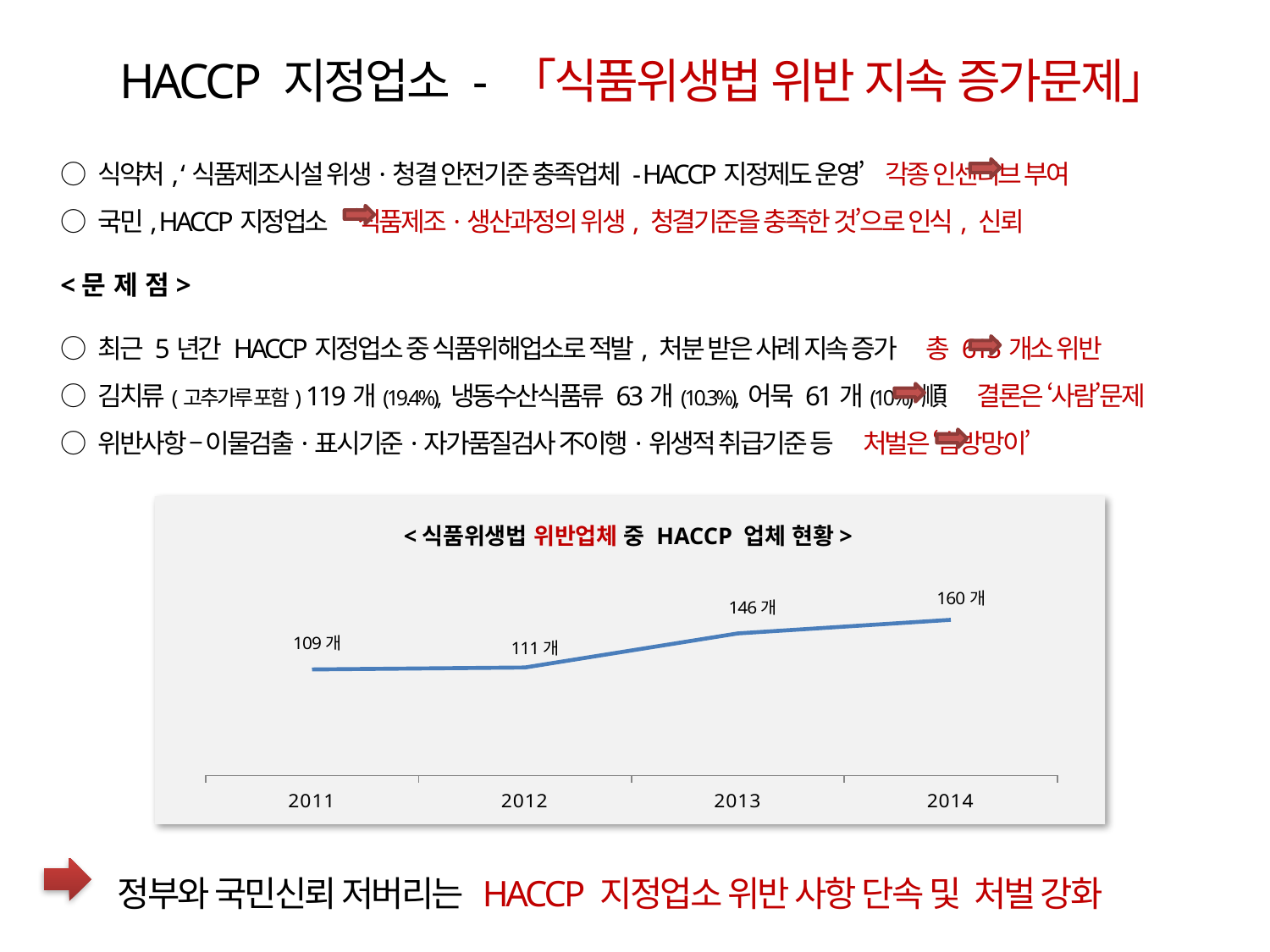
How many years are plotted on the x axis of the chart? 4 Which is larger, the value for 2012 or the value for 2013? 2013 Which year has the highest value in the chart? 2014 What kind of chart is shown on the slide? line chart What is the title of the chart? <식품위생법 위반업체 중 HACCP 업체 현황> Which year has the lowest value in the chart? 2011 What is the value for 2013 in the chart? 146 개 Do the values rise or fall from 2011 to 2014? rise What is the difference between the values for 2013 and 2012? 35 개 What is the value for 2014 in the chart? 160 개 What is the difference between the values for 2014 and 2011? 51 개 What is the value for 2011 in the chart? 109 개